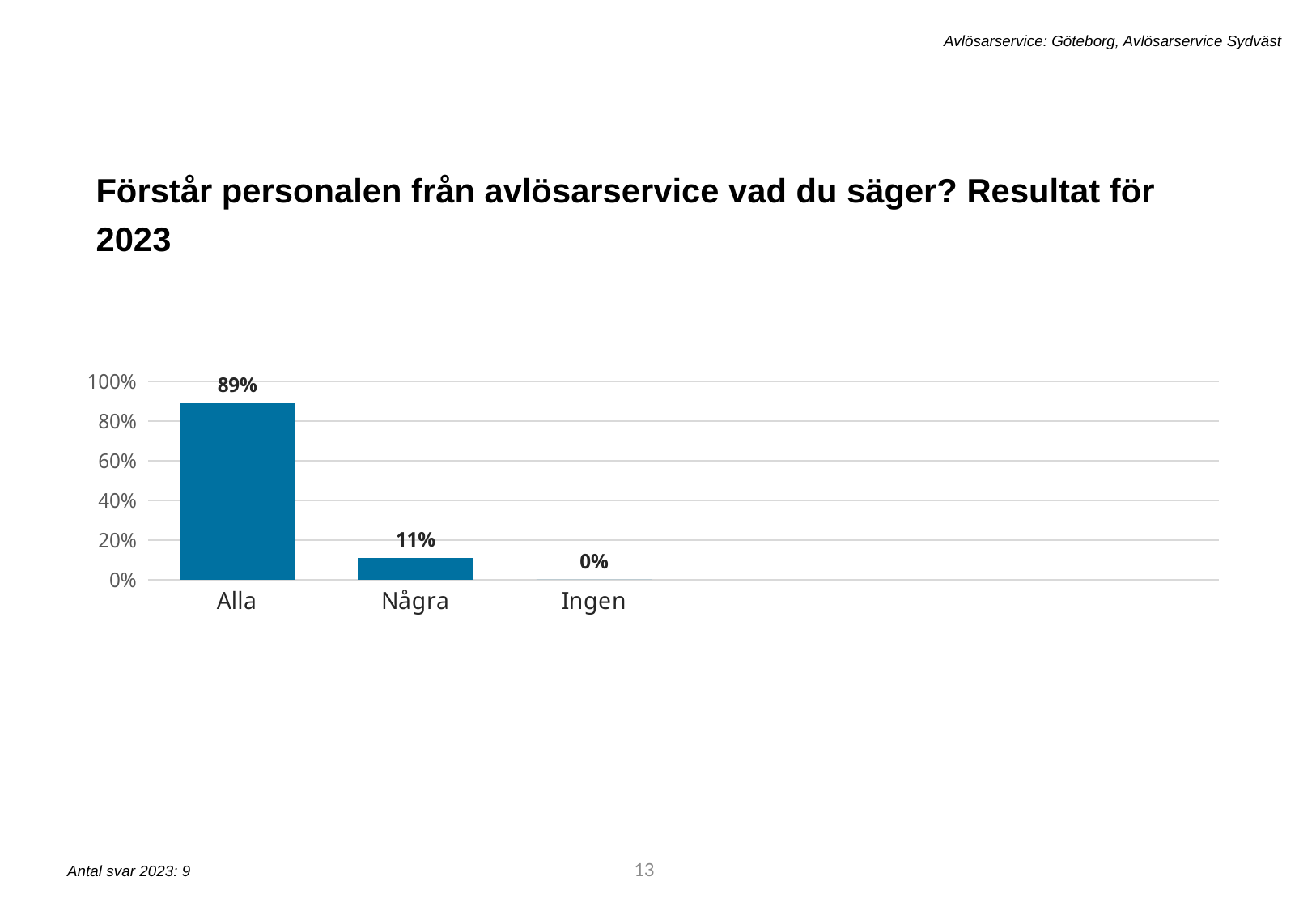
How many categories are shown on the x axis? 3 Which category has the highest value? Alla What is the difference between the values for Alla and Några? 78% Is the value for Några greater or less than 20%? less Is the value for Alla greater or less than 80%? greater What is the value for Några? 11% What kind of chart is shown on the slide? bar chart Which category has the lowest value? Ingen Which is larger, the value for Några or the value for Ingen? Några Do the values rise or fall from left to right along the x axis? fall What is the value for Alla? 89% What is the value for Ingen? 0%